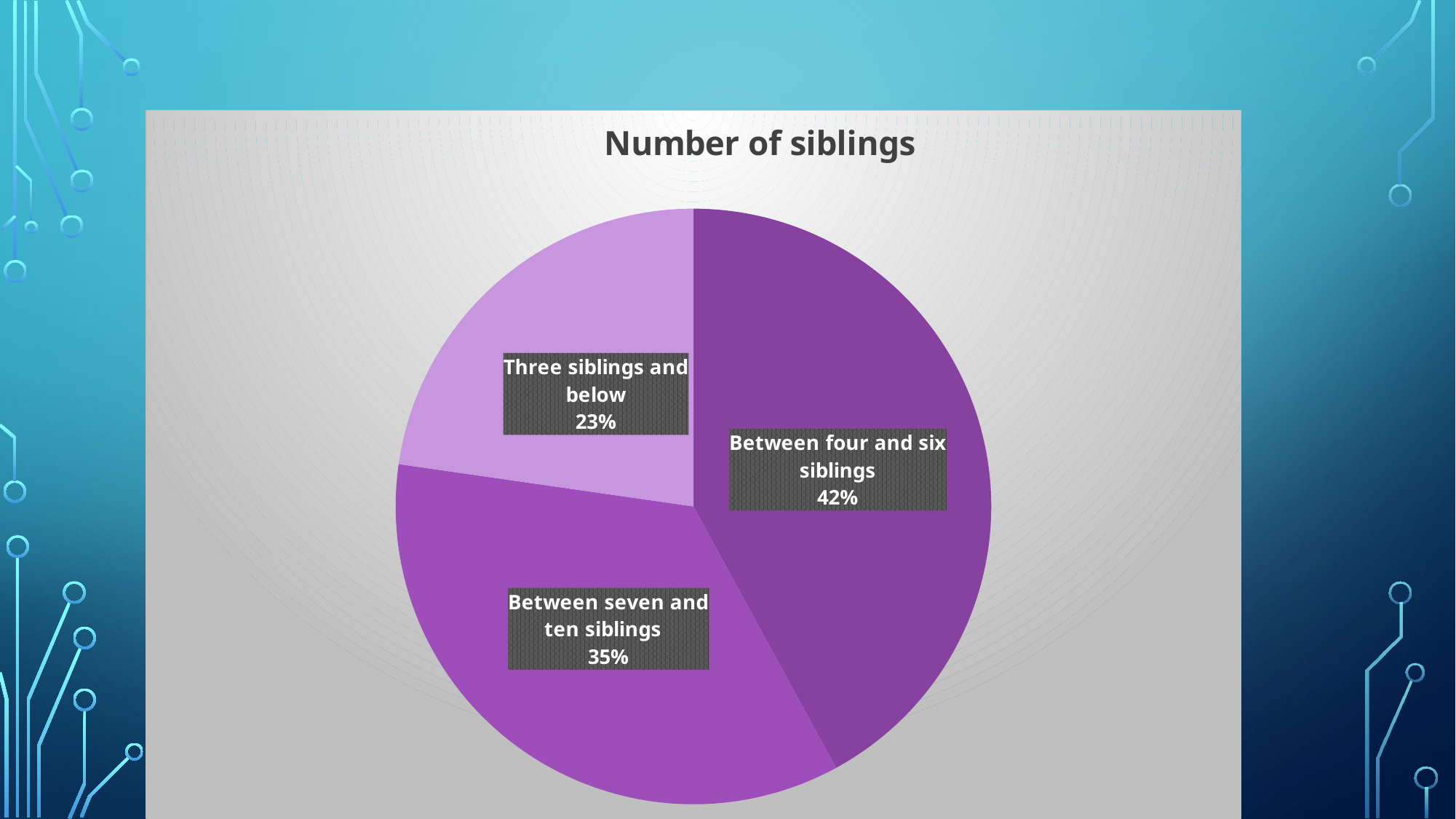
What share of the pie is 'Between four and six siblings'? 42% Which slice is shown in the lightest shade of purple? Three siblings and below Which is larger: the share for 'Between seven and ten siblings' or the share for 'Three siblings and below'? Between seven and ten siblings What kind of chart is shown on the slide? Pie chart What is the title of the chart? Number of siblings Which category has the smallest slice of the pie? Three siblings and below What share of the pie is 'Three siblings and below'? 23% What is the difference in percentage points between 'Between seven and ten siblings' and 'Three siblings and below'? 12 How many slices does the pie chart have? 3 What share of the pie is 'Between seven and ten siblings'? 35% Which category has the largest slice of the pie? Between four and six siblings What is the difference in percentage points between 'Between four and six siblings' and 'Three siblings and below'? 19